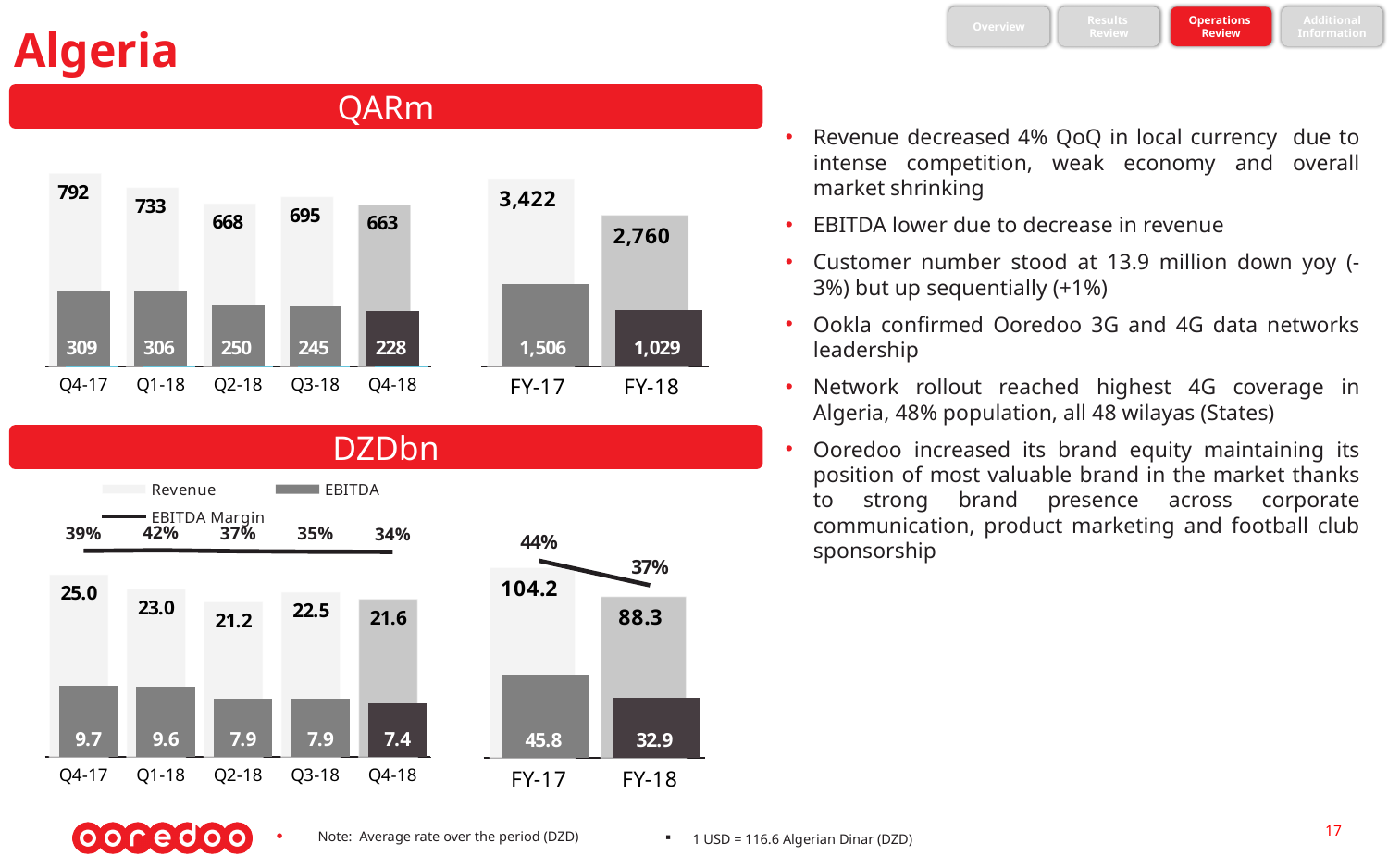
In the DZDbn quarterly chart, which is larger, the revenue for Q2-18 or Q3-18? Q3-18 How many quarters are shown in the QARm quarterly chart? 5 In the QARm quarterly chart, what is the EBITDA for Q2-18? 250 In the DZDbn quarterly chart, what is the revenue for Q3-18? 22.5 In the QARm full-year chart, what is the revenue for FY-18? 2,760 In the DZDbn full-year chart, what is the EBITDA for FY-17? 45.8 In the QARm quarterly chart, which quarter has the lowest EBITDA? Q4-18 In the DZDbn full-year chart, what is the EBITDA margin for FY-18? 37% In the DZDbn quarterly chart, what is the EBITDA margin for Q1-18? 42% How many series does the legend in the DZDbn section list? 3 In the QARm quarterly chart, what is the revenue for Q4-17? 792 In the QARm full-year chart, what is the difference between FY-17 and FY-18 EBITDA? 477